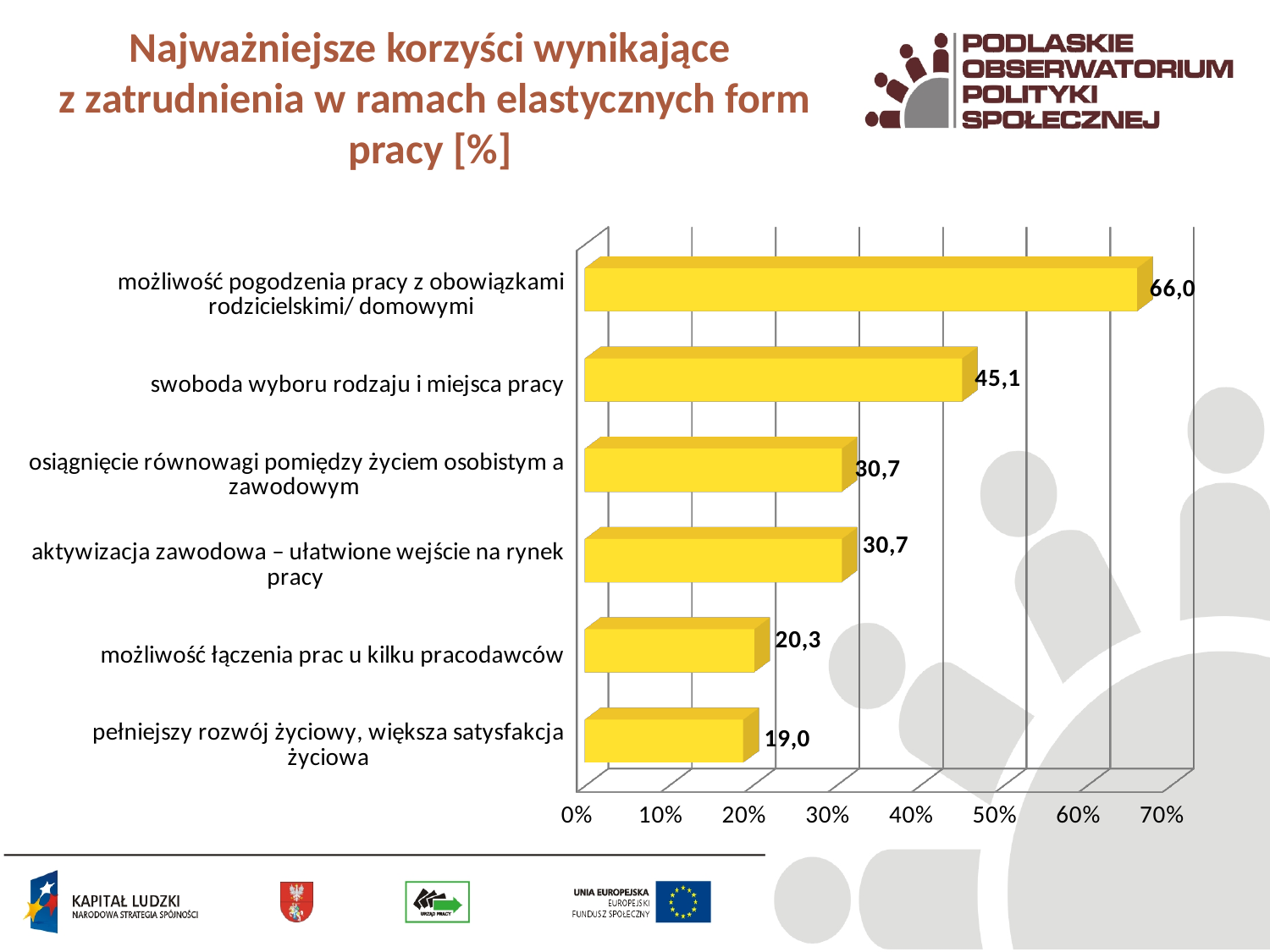
What is the value for "możliwość pogodzenia pracy z obowiązkami rodzicielskimi/ domowymi"? 66,0 What is the value for "swoboda wyboru rodzaju i miejsca pracy"? 45,1 What kind of chart is shown on the slide? bar chart Is the value for "osiągnięcie równowagi pomiędzy życiem osobistym a zawodowym" greater or less than 40%? less Which category has the highest value? możliwość pogodzenia pracy z obowiązkami rodzicielskimi/ domowymi Which is larger: the value for "swoboda wyboru rodzaju i miejsca pracy" or for "aktywizacja zawodowa – ułatwione wejście na rynek pracy"? swoboda wyboru rodzaju i miejsca pracy What is the value for "pełniejszy rozwój życiowy, większa satysfakcja życiowa"? 19,0 How many categories are shown in the chart? 6 What is the difference between the values for "możliwość pogodzenia pracy z obowiązkami rodzicielskimi/ domowymi" and "swoboda wyboru rodzaju i miejsca pracy"? 20,9 What is the value for "możliwość łączenia prac u kilku pracodawców"? 20,3 Which category has the lowest value? pełniejszy rozwój życiowy, większa satysfakcja życiowa What is the title of the chart on the slide? Najważniejsze korzyści wynikające z zatrudnienia w ramach elastycznych form pracy [%]